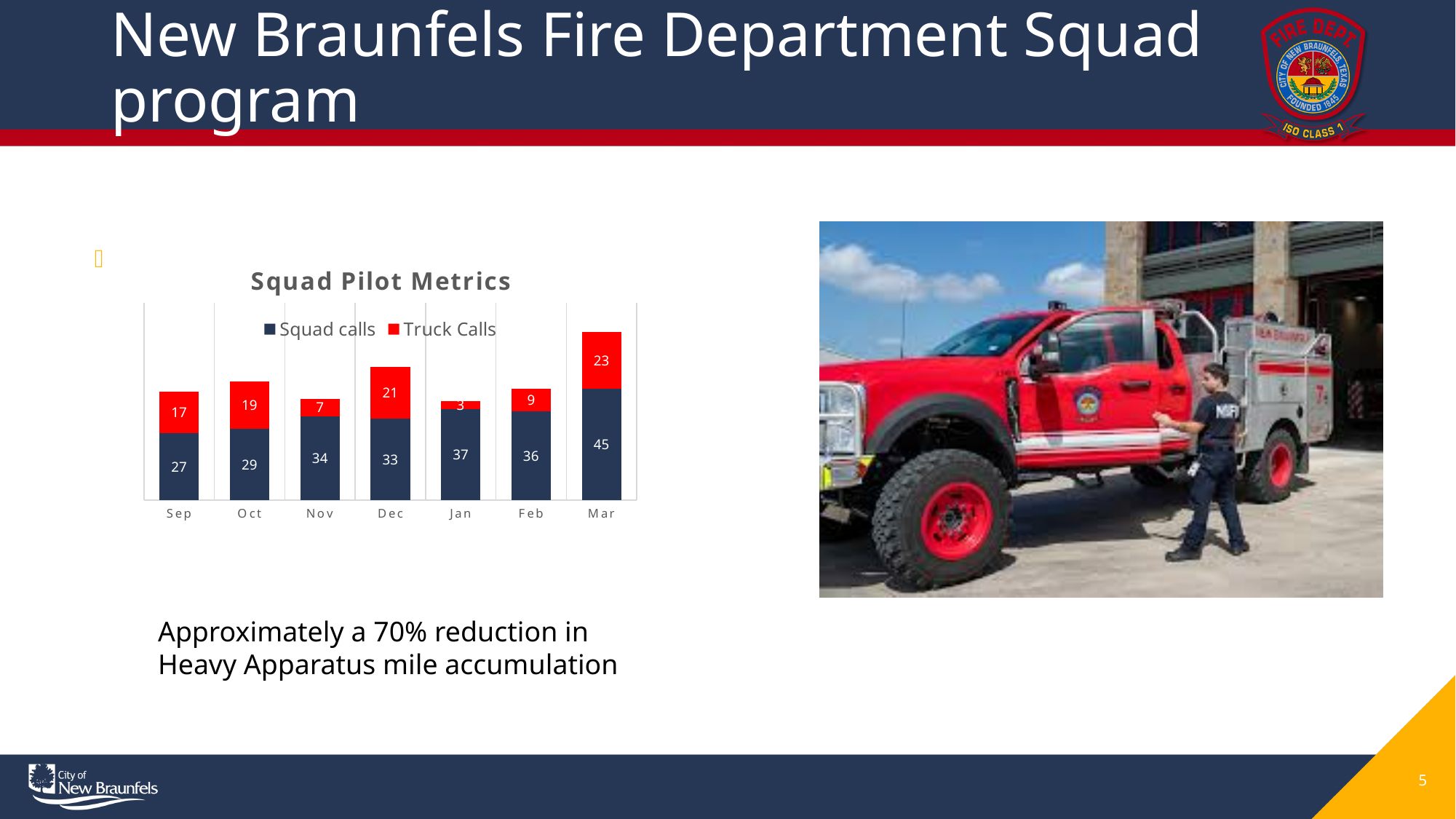
How many series does the legend list? 2 Which month has the lowest number of Truck Calls? Jan How many months are shown on the x axis? 7 What type of chart is shown? Stacked bar chart Which month has the highest number of Squad calls? Mar What is the value of Squad calls for Sep? 27 What is the total of the stacked bar for Jan? 40 What is the total of the stacked bar for Mar? 68 What is the value of Squad calls for Mar? 45 What is the value of Truck Calls for Dec? 21 What is the difference between Squad calls in Mar and Squad calls in Sep? 18 Which is larger: Truck Calls in Oct or Truck Calls in Feb? Truck Calls in Oct